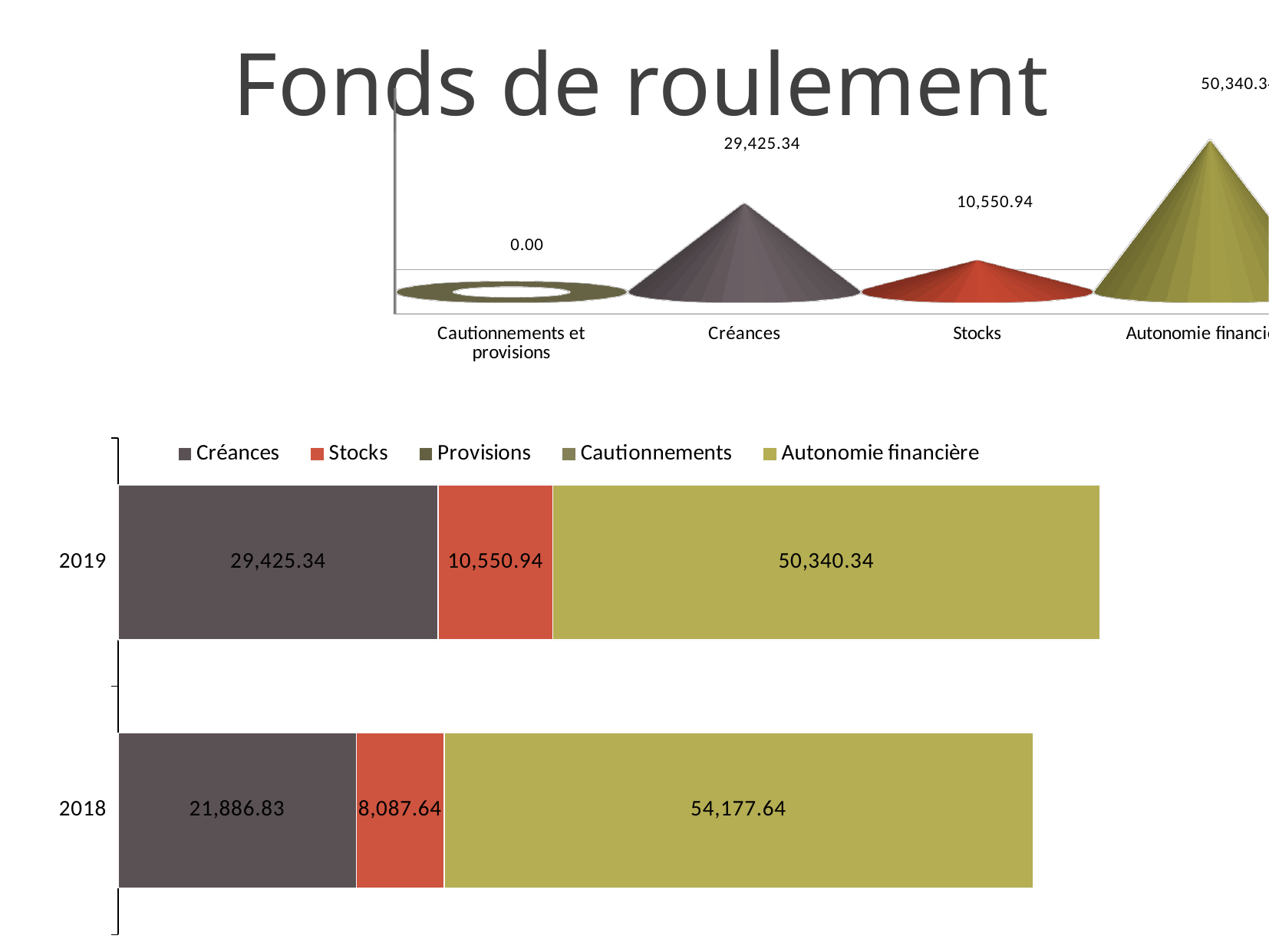
In the top chart, what value is shown for Cautionnements et provisions? 0.00 What kind of chart is the bottom chart? Stacked bar chart In the bottom stacked bar chart, what is the value of Créances for 2019? 29,425.34 In the bottom stacked bar chart, what is the value of Autonomie financière for 2018? 54,177.64 In the bottom stacked bar chart, what is the value of Stocks for 2018? 8,087.64 In the bottom stacked bar chart, what is the difference between Créances in 2019 and Créances in 2018? 7,538.51 In the top chart, what value is shown for Stocks? 10,550.94 In the bottom stacked bar chart, is Autonomie financière larger in 2018 or in 2019? 2018 In the bottom stacked bar chart, which series has the largest segment in the 2019 bar? Autonomie financière What is the title of the slide? Fonds de roulement How many series does the legend of the bottom stacked bar chart list? 5 In the bottom stacked bar chart, which series has the smallest visible segment in the 2018 bar? Stocks